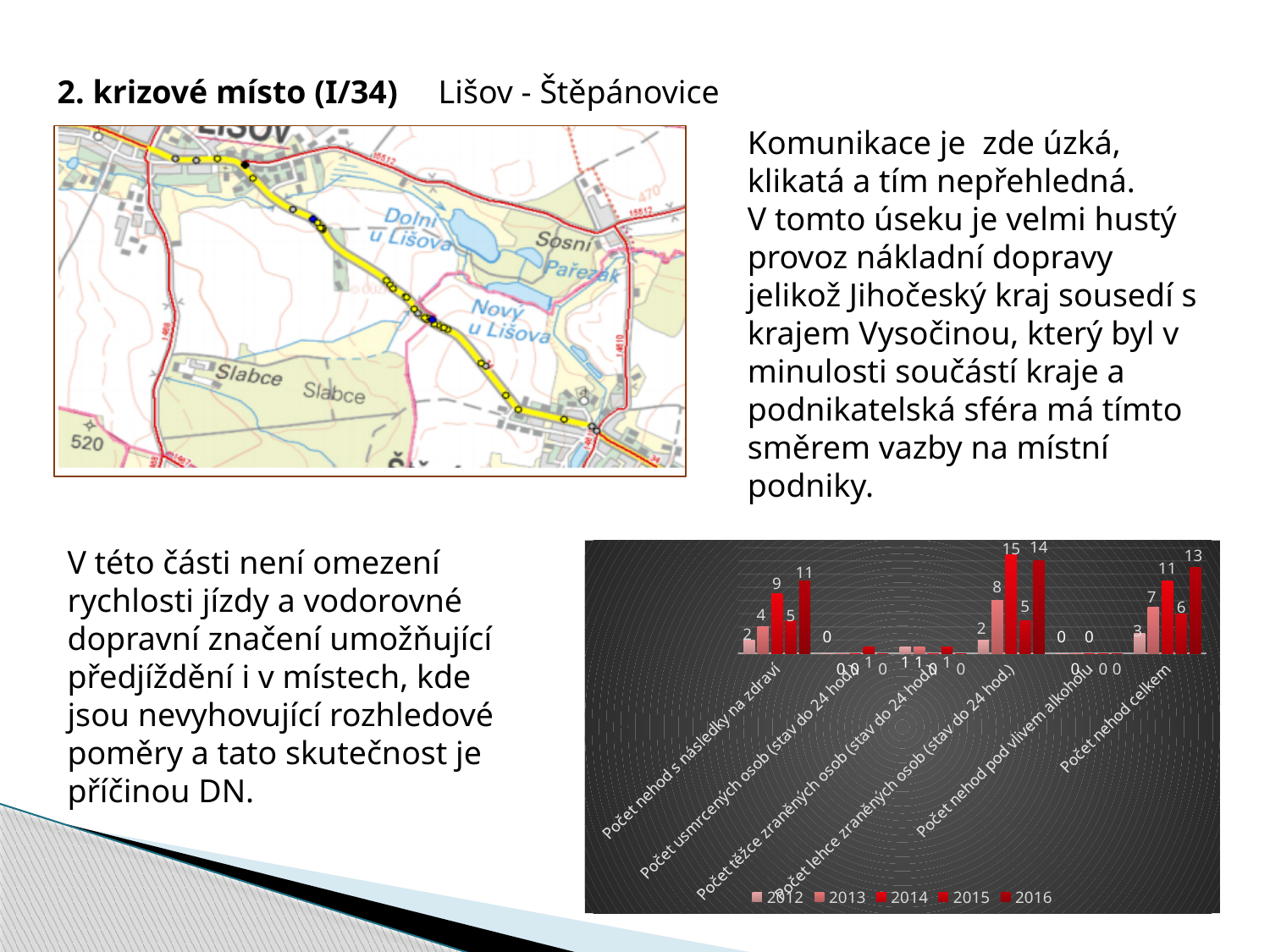
Which years are listed in the chart legend? 2012, 2013, 2014, 2015, 2016 What is the value for 2012 in the category "Počet nehod s následky na zdraví"? 2 In the category "Počet nehod s následky na zdraví", which is larger: the value for 2014 or for 2015? 2014 How many series does the chart legend list? 5 What is the value for 2016 in the category "Počet nehod celkem"? 13 Which year has the highest value in the category "Počet nehod celkem"? 2016 Which year has the highest value in the category "Počet lehce zraněných osob (stav do 24 hod.)"? 2014 What type of chart is shown on the slide? bar chart What is the difference between the 2016 and 2012 values in the category "Počet nehod celkem"? 10 Which year has the lowest value in the category "Počet nehod celkem"? 2012 How many categories are shown on the x axis of the chart? 6 What is the value for 2014 in the category "Počet lehce zraněných osob (stav do 24 hod.)"? 15